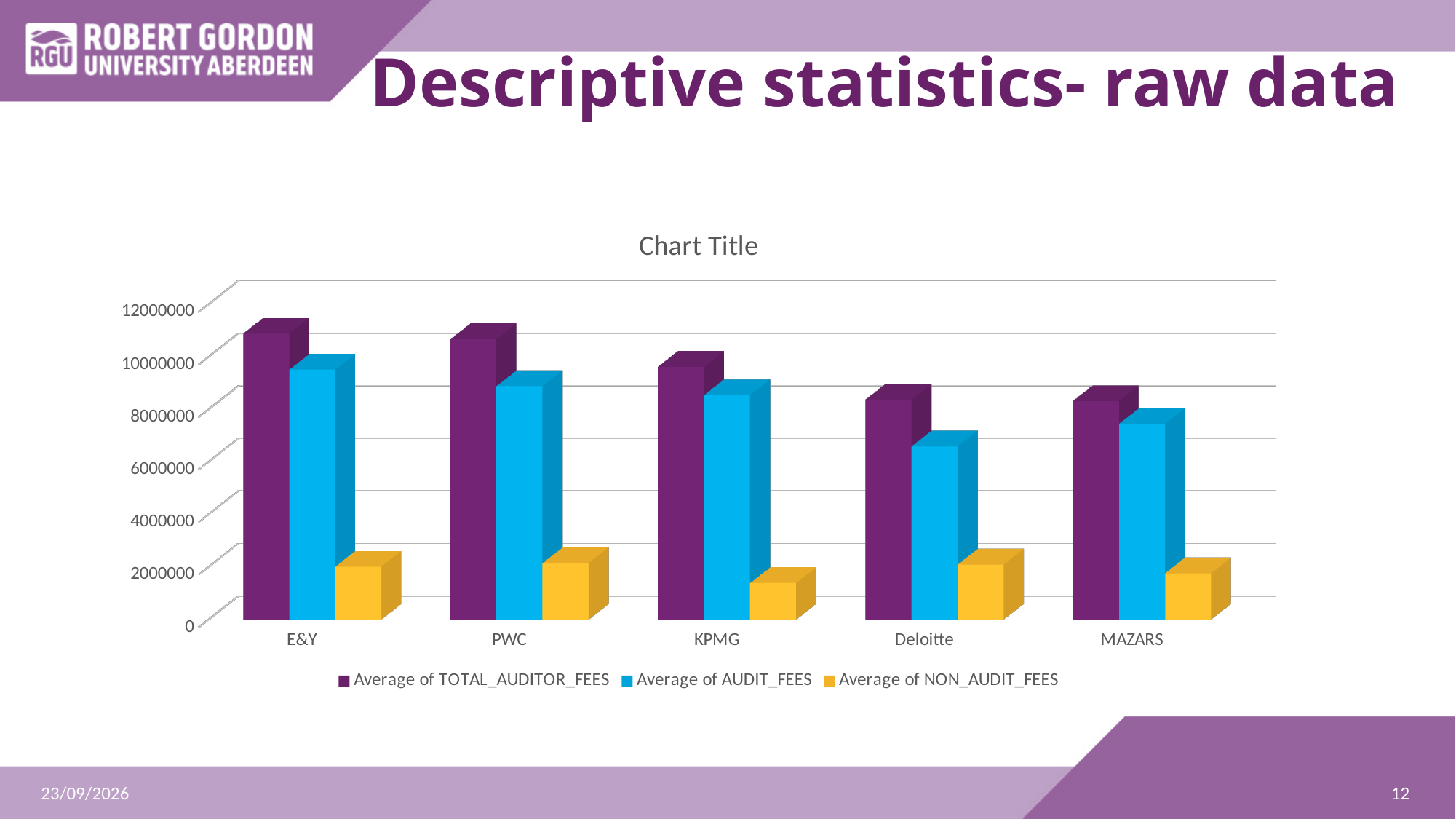
Which is larger, the Average of TOTAL_AUDITOR_FEES for KPMG or for Deloitte? KPMG Which firm has the highest Average of AUDIT_FEES? E&Y Does the Average of TOTAL_AUDITOR_FEES generally rise or fall from E&Y to MAZARS along the x axis? fall Which firm has the lowest Average of NON_AUDIT_FEES? KPMG What kind of chart is shown on the slide? Bar chart Is the Average of TOTAL_AUDITOR_FEES for E&Y greater or less than 10000000? greater Is the Average of NON_AUDIT_FEES for KPMG greater or less than 2000000? less Which firm has the lowest Average of AUDIT_FEES? Deloitte What colour are the bars for Average of NON_AUDIT_FEES? Yellow How many audit firms are shown on the x axis of the chart? 5 Is the Average of AUDIT_FEES for MAZARS greater or less than 8000000? less How many series does the chart's legend list? 3